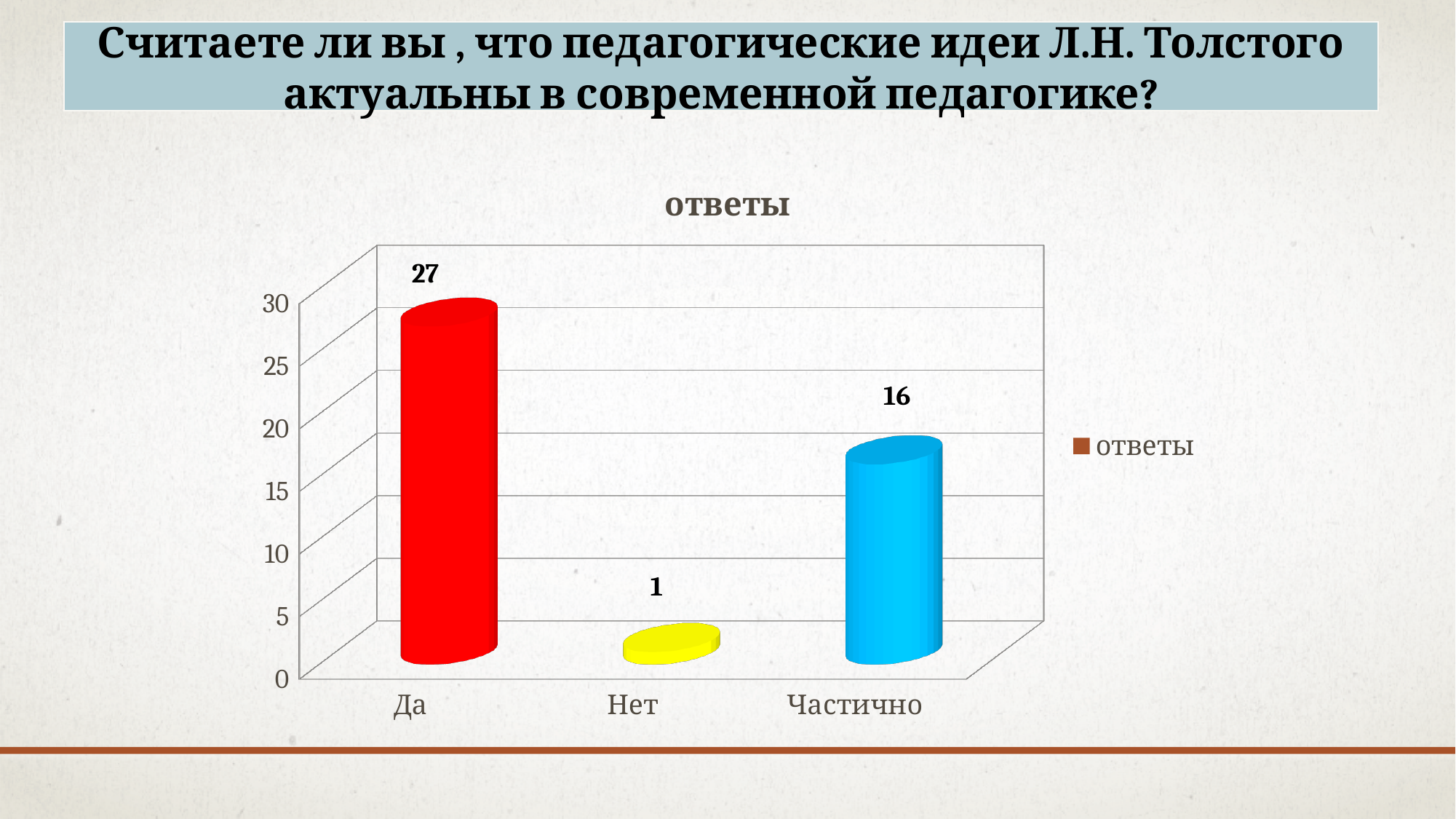
What is the value for Нет? 1 What kind of chart is shown? bar chart What is the title of the chart? ответы What is the value for Да? 27 What is the difference between the values for Частично and Нет? 15 Which category has the highest value? Да What is the difference between the values for Да and Частично? 11 Which is larger, the value for Да or the value for Частично? Да What is the value for Частично? 16 How many categories are shown on the x axis? 3 How many series does the legend list? 1 Which category has the lowest value? Нет